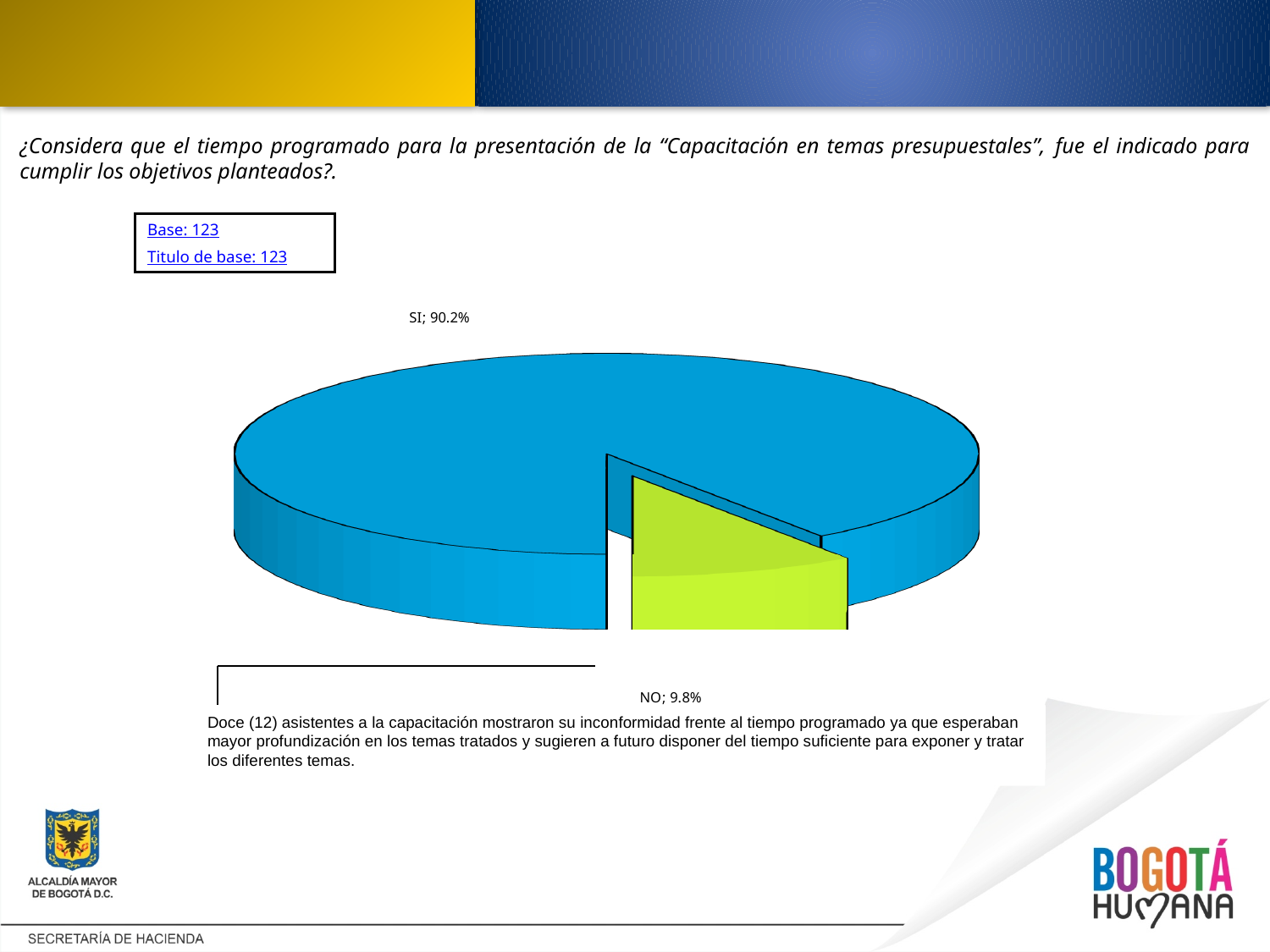
What colour is the SI slice of the pie chart? Blue What percentage of the pie chart is labelled NO? 9.8% What kind of chart is shown on the slide? Pie chart How many slices does the pie chart have? 2 What colour is the NO slice of the pie chart? Green What is the difference in percentage points between the SI and NO slices? 80.4 Which slice is larger, SI or NO? SI Which slice of the pie chart is the smallest? NO What percentage of the pie chart is labelled SI? 90.2% Which slice of the pie chart is the largest? SI What share of the pie does the NO slice represent? 9.8% Is the value for SI greater or less than 50%? greater